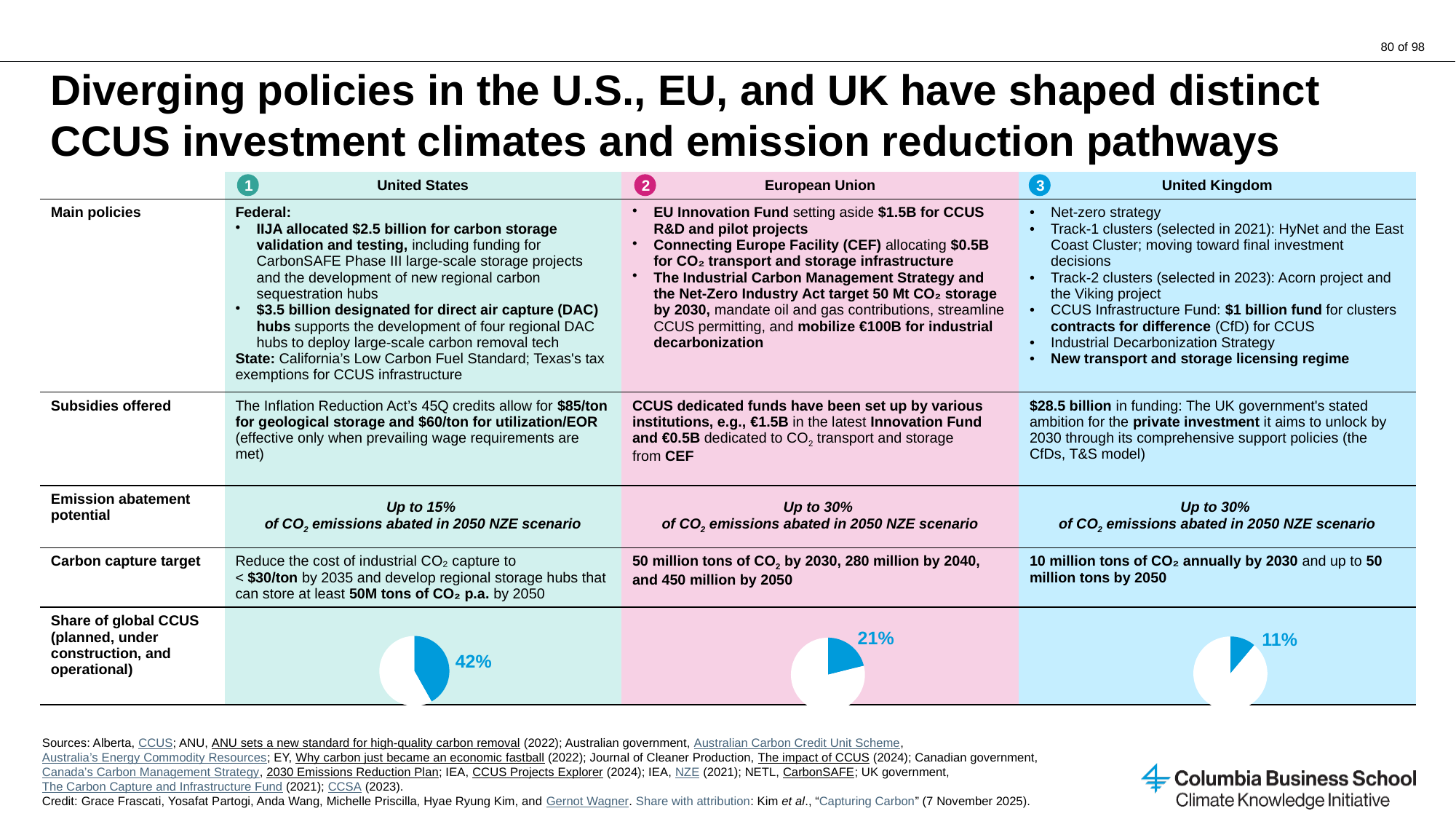
Among the three 'Share of global CCUS' pie charts, which region has the lowest share? United Kingdom In the 'Share of global CCUS' pie charts, what colour is the highlighted slice representing each region's share? Blue In the 'Share of global CCUS' row, what share does the pie chart for the United Kingdom show? 11% Among the three 'Share of global CCUS' pie charts, which region has the highest share? United States In the 'Share of global CCUS' pie charts, what is the difference between the United States share and the European Union share? 21% In the 'Share of global CCUS' row, what share does the pie chart for the European Union show? 21% In the 'Share of global CCUS' pie charts, what is the difference between the European Union share and the United Kingdom share? 10% What kind of chart is used in the 'Share of global CCUS' row of the table? Pie chart In the 'Share of global CCUS' row, what share does the pie chart for the United States show? 42% How many pie charts are shown in the 'Share of global CCUS' row? 3 In the 'Share of global CCUS' pie charts, which is larger: the United States share or the European Union share? United States In the 'Share of global CCUS' pie charts, which is larger: the European Union share or the United Kingdom share? European Union